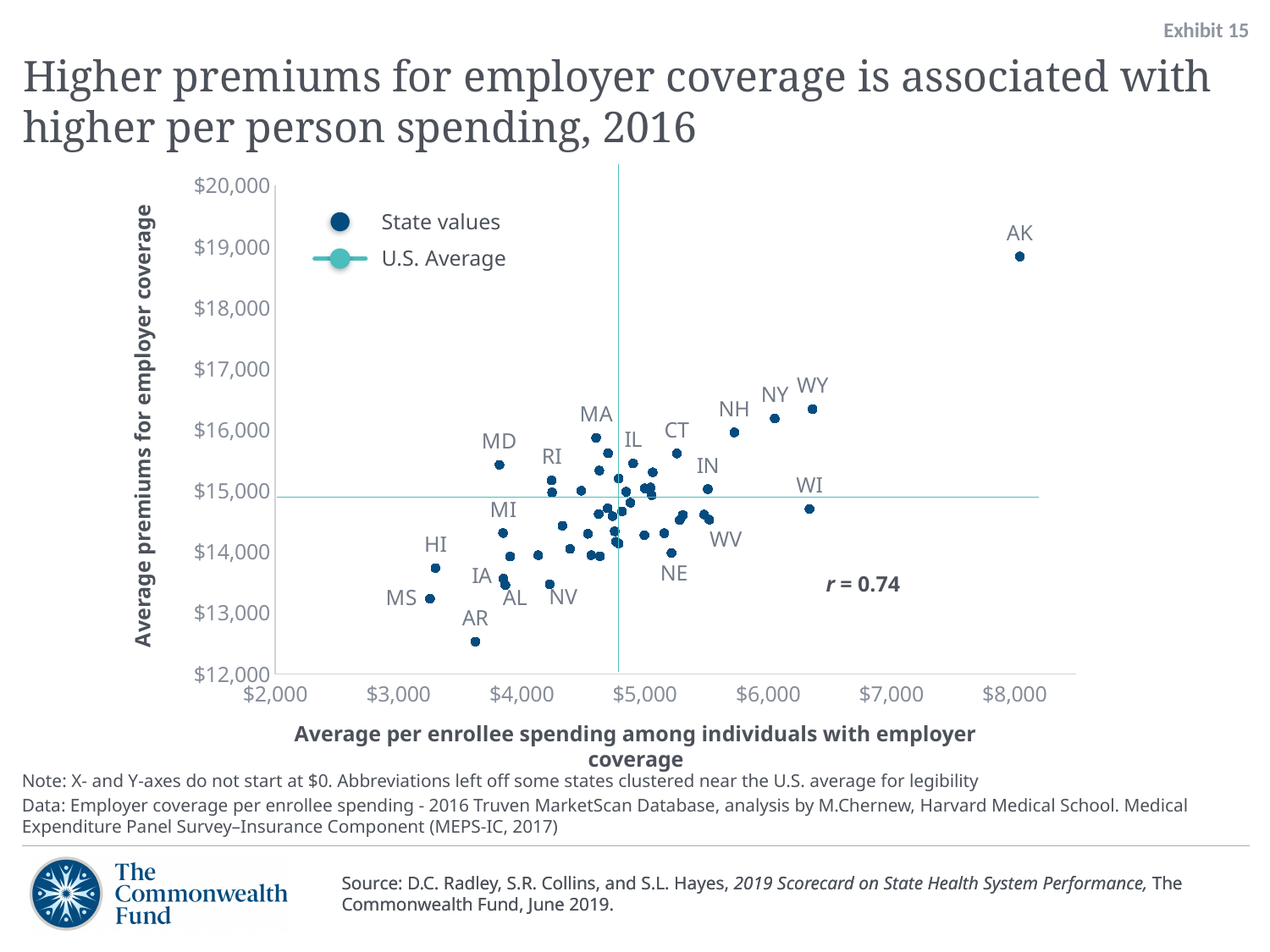
How many series does the legend list? 2 What correlation coefficient (r) is shown on the chart? r = 0.74 Is the average per enrollee spending for MS greater or less than $4,000? less What kind of chart is shown on the slide? Scatter plot Which state has the lowest average premium for employer coverage? AR Which state has a higher average premium, HI or AR? HI Is the average premium for WY greater or less than $16,000? greater Is the average premium for AR greater or less than $13,000? less Which state has the highest average premium for employer coverage? AK Which state has the lowest average per enrollee spending? MS